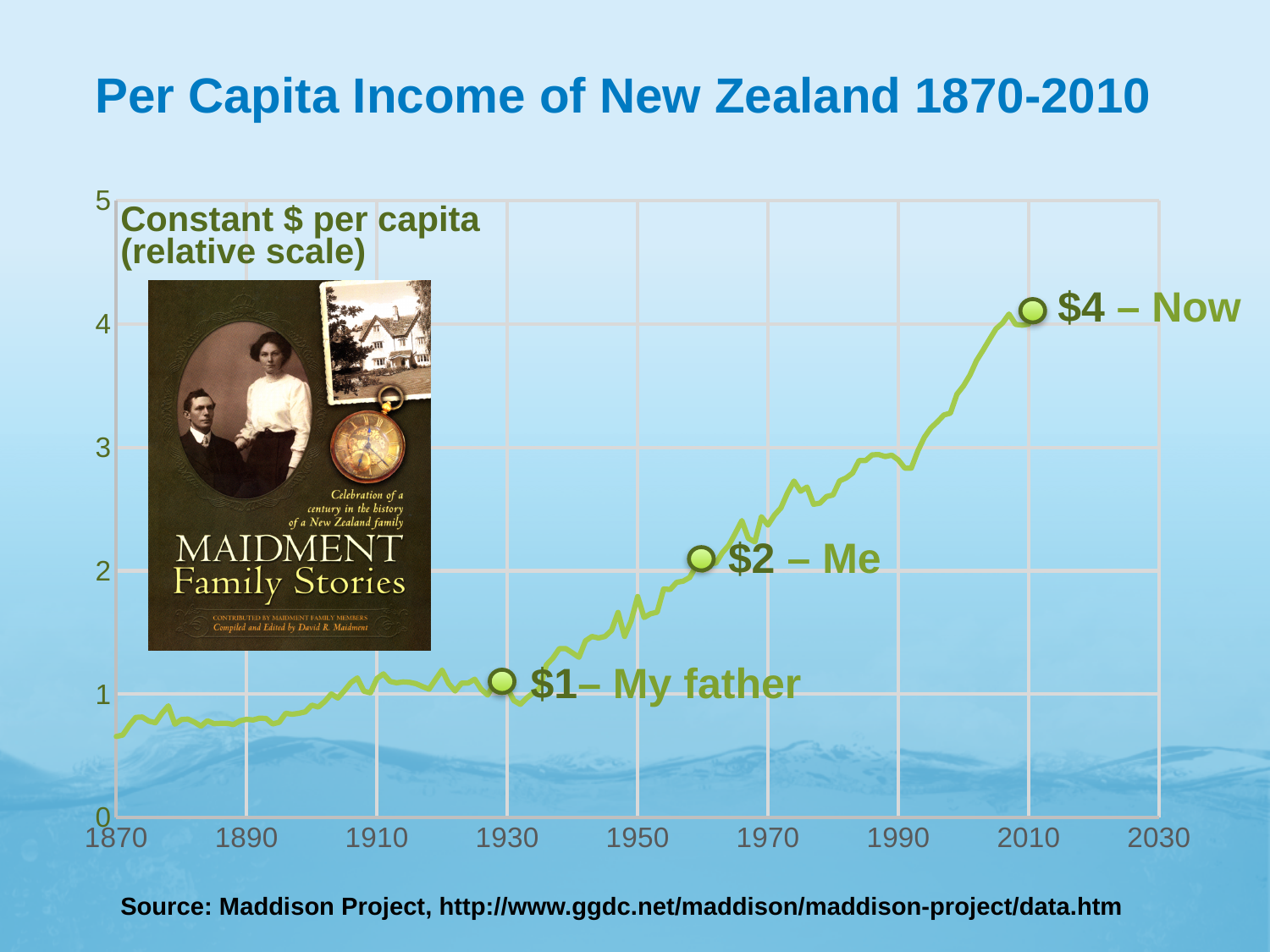
What is the difference between the value labelled "Now" and the value labelled "My father"? $3 Overall, does per capita income rise or fall from 1870 to 2010? rise What kind of chart is shown on the slide? line chart Is the value for 1870 greater or less than 1? less Which of the three labelled points has the highest value? $4 – Now Is the value for 1970 greater or less than 2? greater Which labelled point has the higher value, "Me" or "My father"? Me What value is labelled at the point marked "Now"? $4 What value is labelled at the point marked "Me"? $2 What is the title of the chart? Per Capita Income of New Zealand 1870-2010 What is the difference between the value labelled "Now" and the value labelled "Me"? $2 What value is labelled at the point marked "My father"? $1